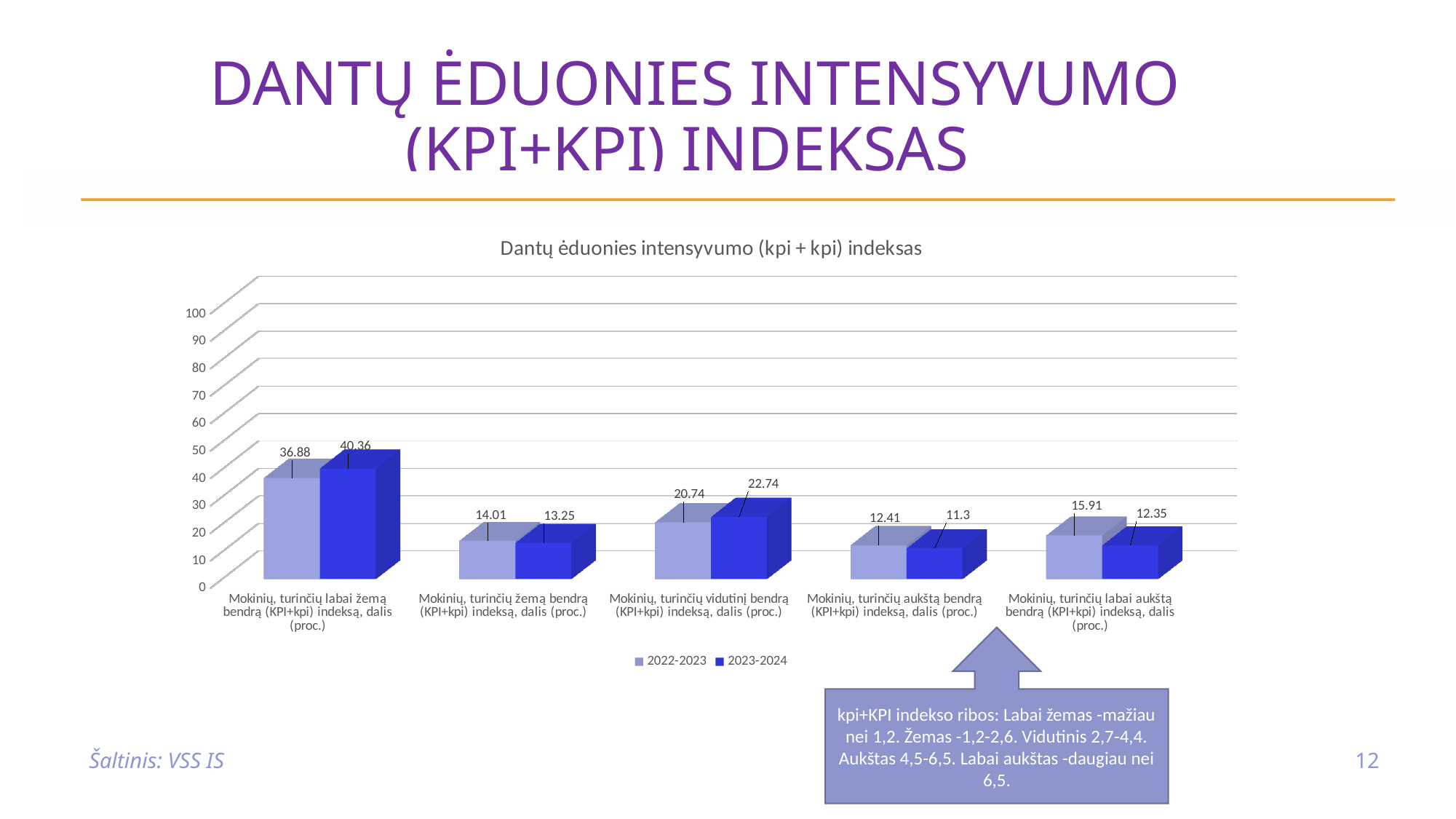
Which category has the highest value for the 2022-2023 series? Mokinių, turinčių labai žemą bendrą (KPI+kpi) indeksą, dalis (proc.) Is the 2022-2023 value for 'Mokinių, turinčių žemą bendrą (KPI+kpi) indeksą, dalis (proc.)' greater or less than 20? less What is the title of the chart? Dantų ėduonies intensyvumo (kpi + kpi) indeksas For the category 'Mokinių, turinčių labai aukštą bendrą (KPI+kpi) indeksą, dalis (proc.)', which series has the larger value, 2022-2023 or 2023-2024? 2022-2023 Which category has the lowest value for the 2023-2024 series? Mokinių, turinčių aukštą bendrą (KPI+kpi) indeksą, dalis (proc.) What is the difference between the 2023-2024 and 2022-2023 values for the category 'Mokinių, turinčių labai žemą bendrą (KPI+kpi) indeksą, dalis (proc.)'? 3.48 What kind of chart is shown on the slide? Bar chart What is the value for 2023-2024 for the category 'Mokinių, turinčių aukštą bendrą (KPI+kpi) indeksą, dalis (proc.)'? 11.3 What is the value for 2023-2024 for the category 'Mokinių, turinčių labai žemą bendrą (KPI+kpi) indeksą, dalis (proc.)'? 40.36 What is the value for 2022-2023 for the category 'Mokinių, turinčių vidutinį bendrą (KPI+kpi) indeksą, dalis (proc.)'? 20.74 How many series does the chart legend list? 2 How many categories are shown on the x axis of the chart? 5